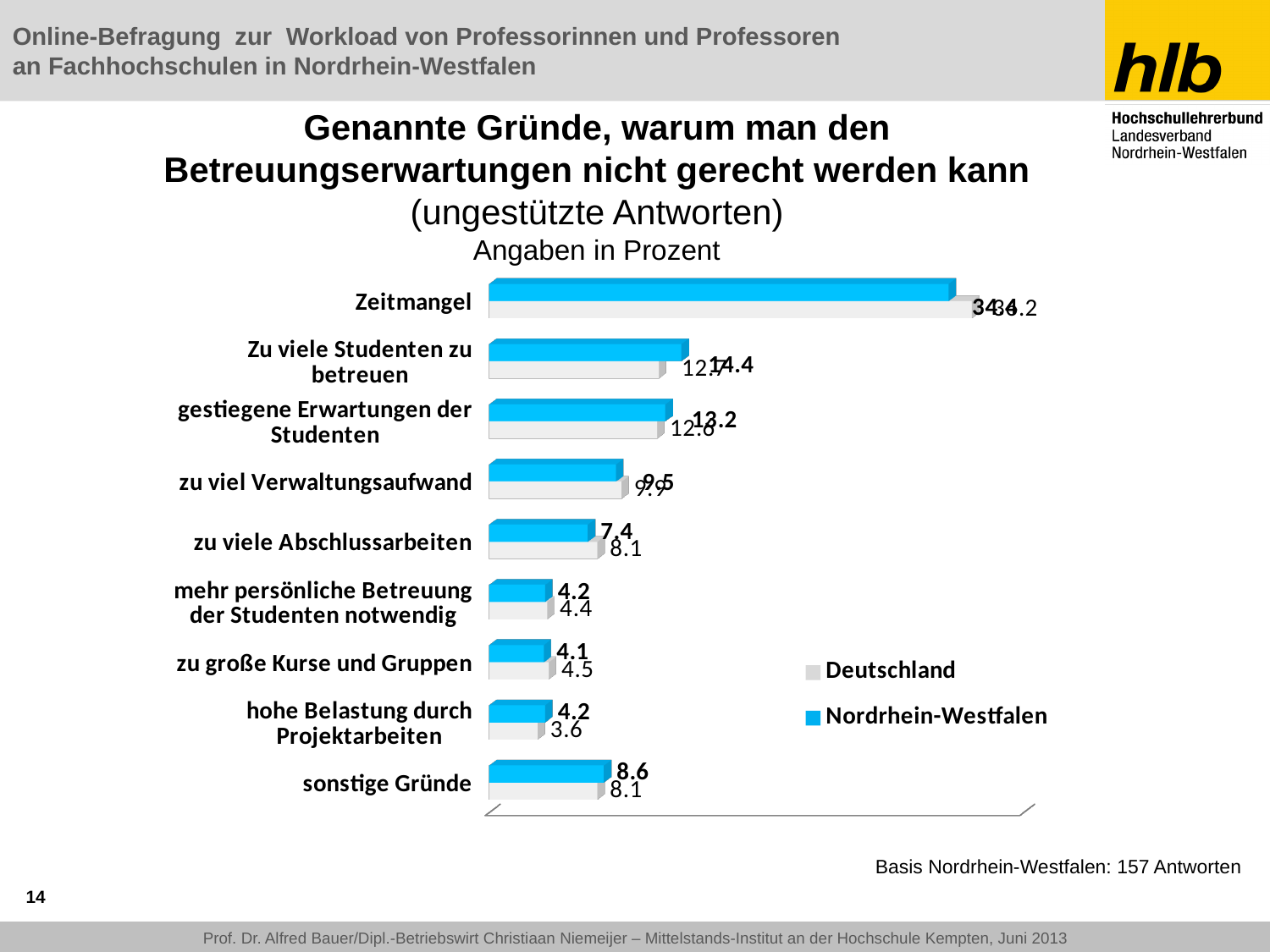
Which reason has the highest value in the chart? Zeitmangel What is the Nordrhein-Westfalen value for 'sonstige Gründe'? 8.6 How many categories (reasons) are plotted in the chart? 9 What is the Deutschland value for 'zu große Kurse und Gruppen'? 4.5 What is the Deutschland value for 'hohe Belastung durch Projektarbeiten'? 3.6 For 'hohe Belastung durch Projektarbeiten', which series has the larger value, Deutschland or Nordrhein-Westfalen? Nordrhein-Westfalen Which colour represents Nordrhein-Westfalen in the legend? blue What is the Deutschland value for 'zu viele Abschlussarbeiten'? 8.1 How many series does the legend list? 2 What is the Nordrhein-Westfalen value for 'zu viele Abschlussarbeiten'? 7.4 What kind of chart is shown on the slide? bar chart For 'sonstige Gründe', what is the difference between the Nordrhein-Westfalen value and the Deutschland value? 0.5